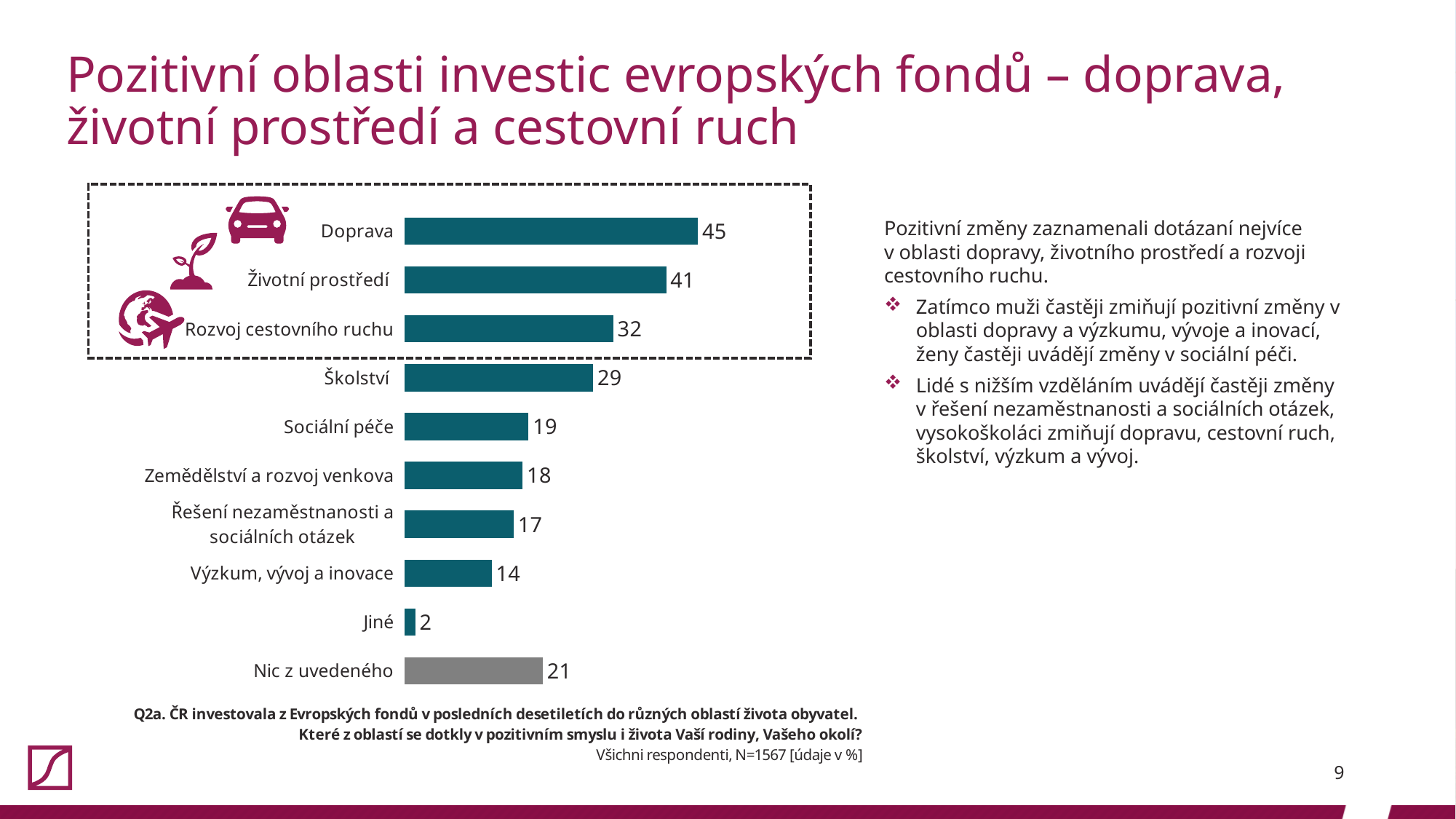
What is the difference between the values for Doprava and Životní prostředí? 4 What is the value for Sociální péče? 19 What is the value for Doprava? 45 Which is larger, the value for Zemědělství a rozvoj venkova or the value for Výzkum, vývoj a inovace? Zemědělství a rozvoj venkova How many categories are shown in the chart? 10 What is the value for Nic z uvedeného? 21 Which bar is shown in a different colour (grey) from the others? Nic z uvedeného What kind of chart is shown on the slide? Bar chart Which category has the lowest value? Jiné What is the value for Rozvoj cestovního ruchu? 32 What is the difference between the values for Školství and Výzkum, vývoj a inovace? 15 Which category has the highest value? Doprava